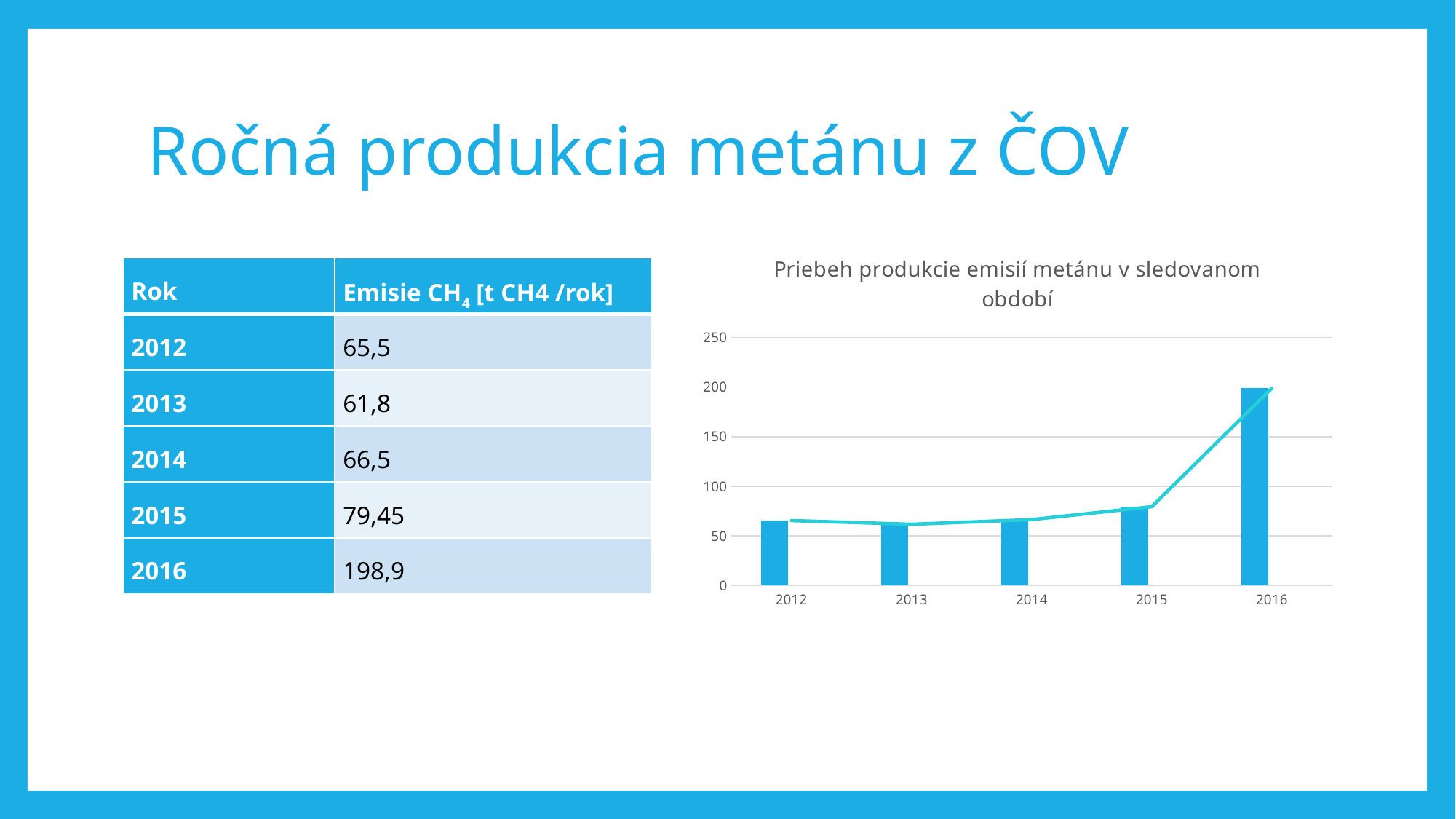
Is the value for 2016 greater or less than 150? greater Which year has the highest methane emission value? 2016 How many years are shown on the x axis of the chart? 5 What is the methane emission value for 2016? 198,9 What is the methane emission value for 2013? 61,8 What is the difference between the 2014 and 2013 methane emission values? 4,7 Which year has the lowest methane emission value? 2013 Which year has the larger methane emission value, 2015 or 2014? 2015 What is the methane emission value for 2015? 79,45 What is the title of the chart? Priebeh produkcie emisií metánu v sledovanom období What is the difference between the 2016 and 2015 methane emission values? 119,45 Do the values generally rise or fall from 2012 to 2016? rise